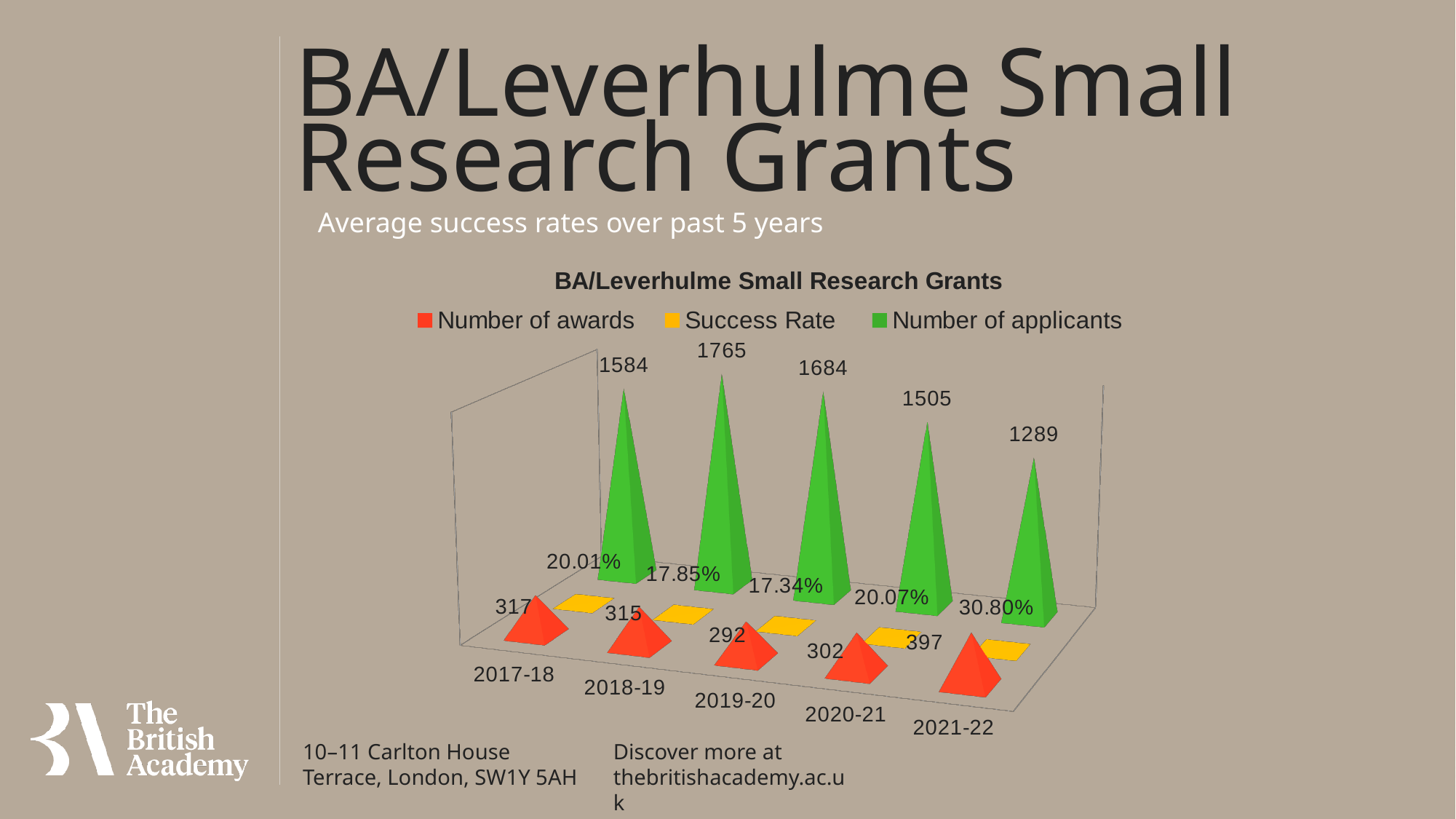
Which year has the highest number of awards? 2021-22 What is the difference in number of applicants between 2017-18 and 2021-22? 295 Which is larger, the number of awards in 2017-18 or in 2020-21? 2017-18 What is the number of applicants for 2018-19? 1765 Which year has the lowest success rate? 2019-20 What is the number of awards for 2019-20? 292 Does the number of applicants rise or fall from 2018-19 to 2021-22? fall How many years are shown on the x axis? 5 What is the success rate for 2021-22? 30.80% How many series does the legend list? 3 What colour represents the Success Rate series in the legend? Yellow Which year has the highest number of applicants? 2018-19